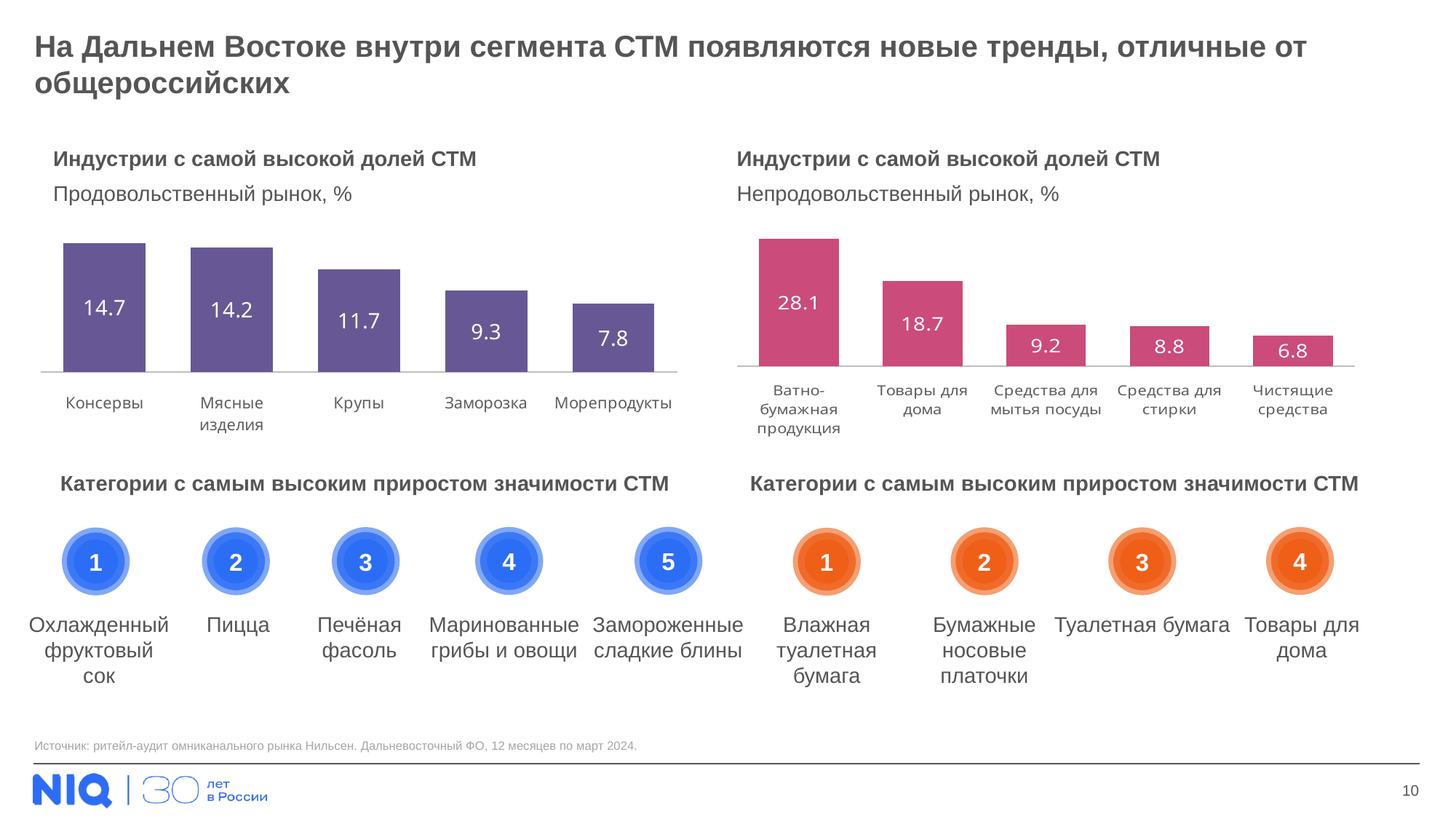
In the right chart (Непродовольственный рынок, %), which is larger: Средства для мытья посуды or Средства для стирки? Средства для мытья посуды In the right chart (Непродовольственный рынок, %), what is the value for Товары для дома? 18.7 In the right chart (Непродовольственный рынок, %), which category has the lowest value? Чистящие средства What kind of chart is the right chart (Непродовольственный рынок, %)? Bar chart How many categories are shown in the right chart (Непродовольственный рынок, %)? 5 In the left chart (Продовольственный рынок, %), what is the difference between Консервы and Морепродукты? 6.9 How many categories are shown in the left chart (Продовольственный рынок, %)? 5 In the left chart (Продовольственный рынок, %), do the values rise or fall from left to right? Fall In the right chart (Непродовольственный рынок, %), what is the difference between Ватно-бумажная продукция and Товары для дома? 9.4 In the left chart (Продовольственный рынок, %), which is larger: Заморозка or Морепродукты? Заморозка In the left chart (Продовольственный рынок, %), what is the value for Крупы? 11.7 In the left chart (Продовольственный рынок, %), which category has the highest value? Консервы